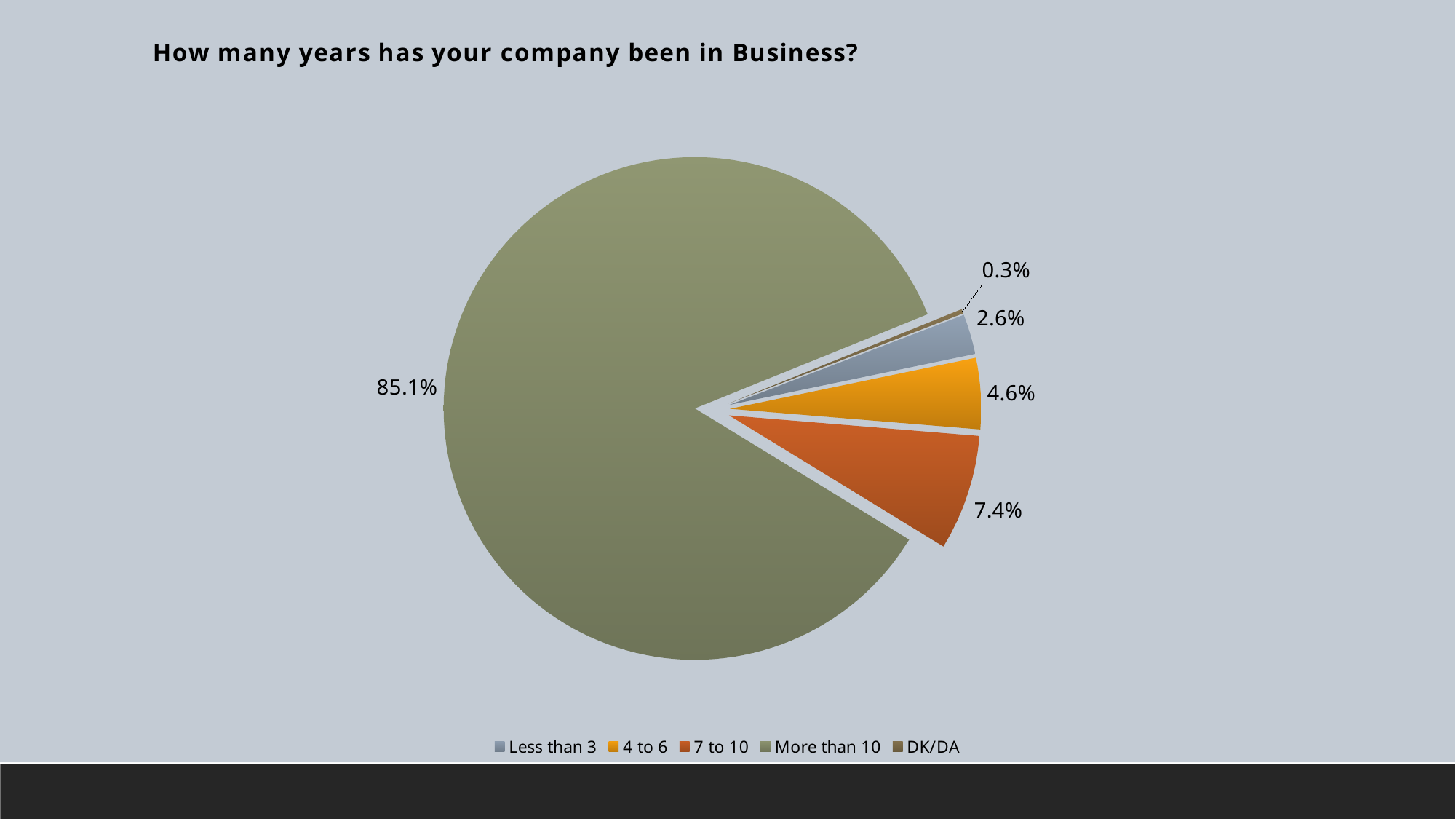
Which is larger, the value for '4 to 6' or the value for 'Less than 3'? 4 to 6 What kind of chart is shown on the slide? Pie chart What is the title of the chart? How many years has your company been in Business? What share of the pie does the 'More than 10' slice represent? 85.1% How many categories does the pie chart show? 5 What is the value for the '7 to 10' category? 7.4% What is the value for the 'DK/DA' category? 0.3% Which category has the smallest slice of the pie? DK/DA What is the value for the '4 to 6' category? 4.6% What is the value for the 'Less than 3' category? 2.6% What is the difference between the '7 to 10' and '4 to 6' values? 2.8% Which category has the largest slice of the pie? More than 10